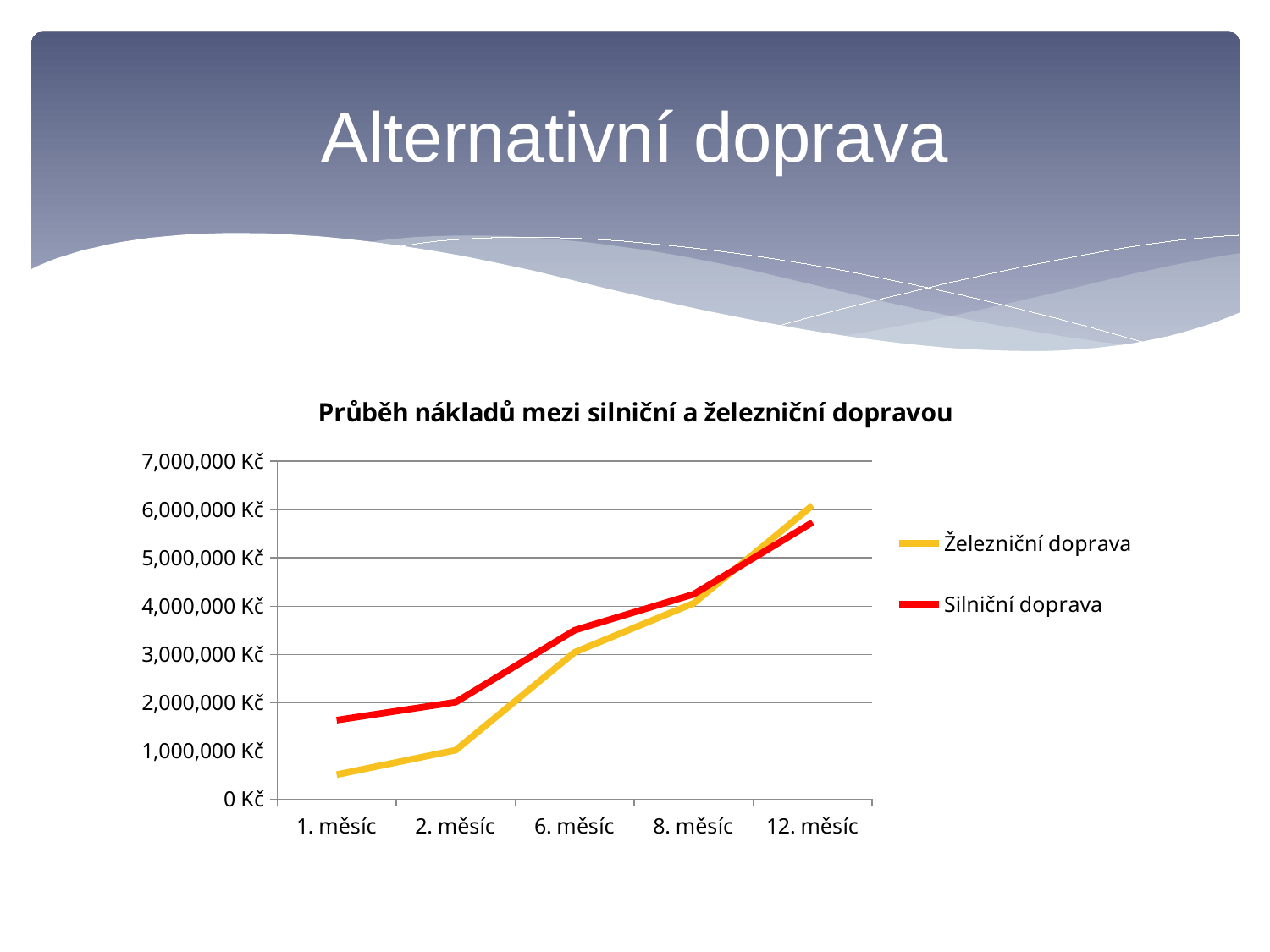
Is the value for Silniční doprava at 12. měsíc greater or less than 5,000,000 Kč? greater Is the value for Silniční doprava at 1. měsíc greater or less than 1,000,000 Kč? greater At 12. měsíc, which series has the higher value, Železniční doprava or Silniční doprava? Železniční doprava Do the values for Železniční doprava rise or fall from 1. měsíc to 12. měsíc? rise At 1. měsíc, which series has the higher value, Železniční doprava or Silniční doprava? Silniční doprava What is the title of the chart? Průběh nákladů mezi silniční a železniční dopravou What colour is the line for Silniční doprava? red Is the value for Železniční doprava at 1. měsíc greater or less than 1,000,000 Kč? less What kind of chart is shown on the slide? line chart How many categories are shown on the x axis? 5 How many series does the legend list? 2